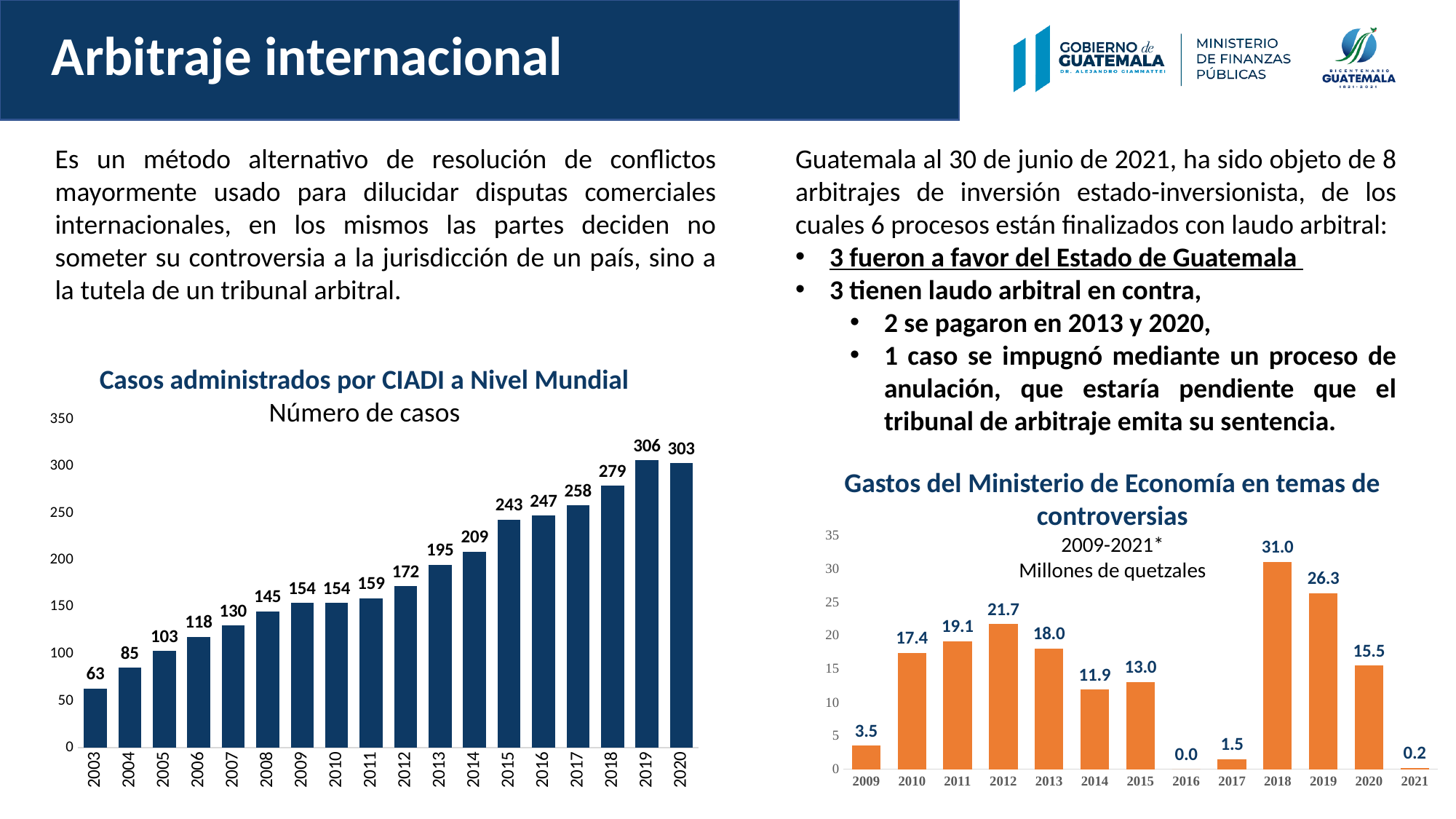
In the chart 'Casos administrados por CIADI a Nivel Mundial', what is the difference between the values for 2020 and 2003? 240 In the chart 'Casos administrados por CIADI a Nivel Mundial', how many years are shown on the x axis? 18 In the chart 'Casos administrados por CIADI a Nivel Mundial', do the values generally rise or fall from 2003 to 2019? rise In the chart 'Gastos del Ministerio de Economía en temas de controversias', which year has the lowest value? 2016 In the chart 'Casos administrados por CIADI a Nivel Mundial', which is larger, the value for 2009 or the value for 2011? 2011 In the chart 'Casos administrados por CIADI a Nivel Mundial', which year has the lowest number of cases? 2003 In the chart 'Gastos del Ministerio de Economía en temas de controversias', what is the difference between the values for 2018 and 2019? 4.7 In the chart 'Casos administrados por CIADI a Nivel Mundial', what is the value for 2019? 306 In the chart 'Gastos del Ministerio de Economía en temas de controversias', which year has the highest value? 2018 In the chart 'Gastos del Ministerio de Economía en temas de controversias', what is the value for 2012? 21.7 What unit is stated under the title of the chart 'Gastos del Ministerio de Economía en temas de controversias'? Millones de quetzales What kind of chart is 'Gastos del Ministerio de Economía en temas de controversias'? bar chart